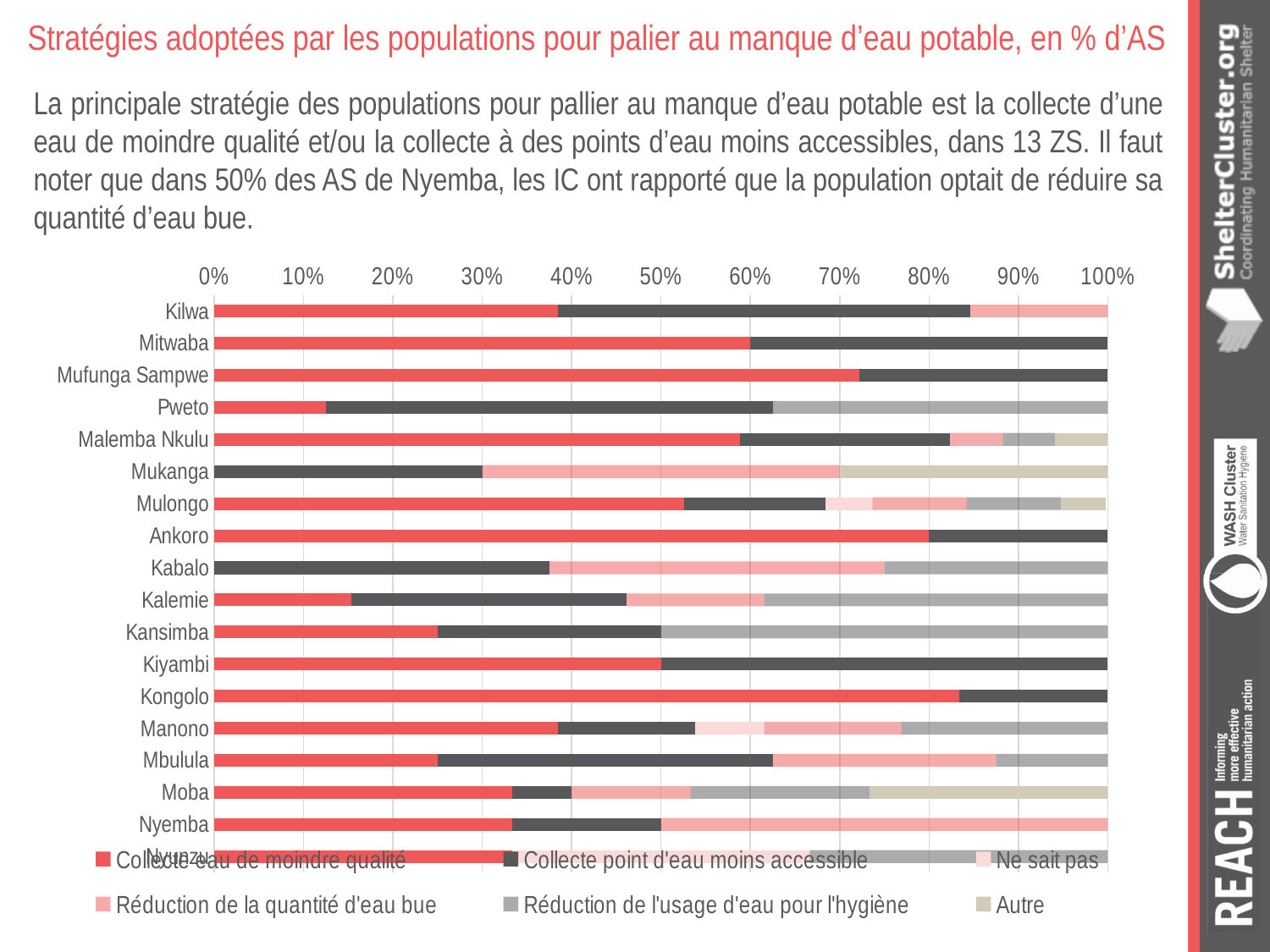
Which has a larger value for 'Collecte eau de moindre qualité', Kilwa or Pweto? Kilwa Is the value for 'Collecte point d'eau moins accessible' in Kabalo greater or less than 30%? greater Which legend entry is shown in the beige/khaki colour? Autre Is the value for 'Réduction de la quantité d'eau bue' in Nyemba greater or less than 40%? greater What is the title of the chart? Stratégies adoptées par les populations pour palier au manque d'eau potable, en % d'AS Which has a larger value for 'Collecte eau de moindre qualité', Mitwaba or Kansimba? Mitwaba How many series does the legend list? 6 Is the value for 'Collecte eau de moindre qualité' in Pweto greater or less than 20%? less What kind of chart is shown on the slide? Stacked bar chart